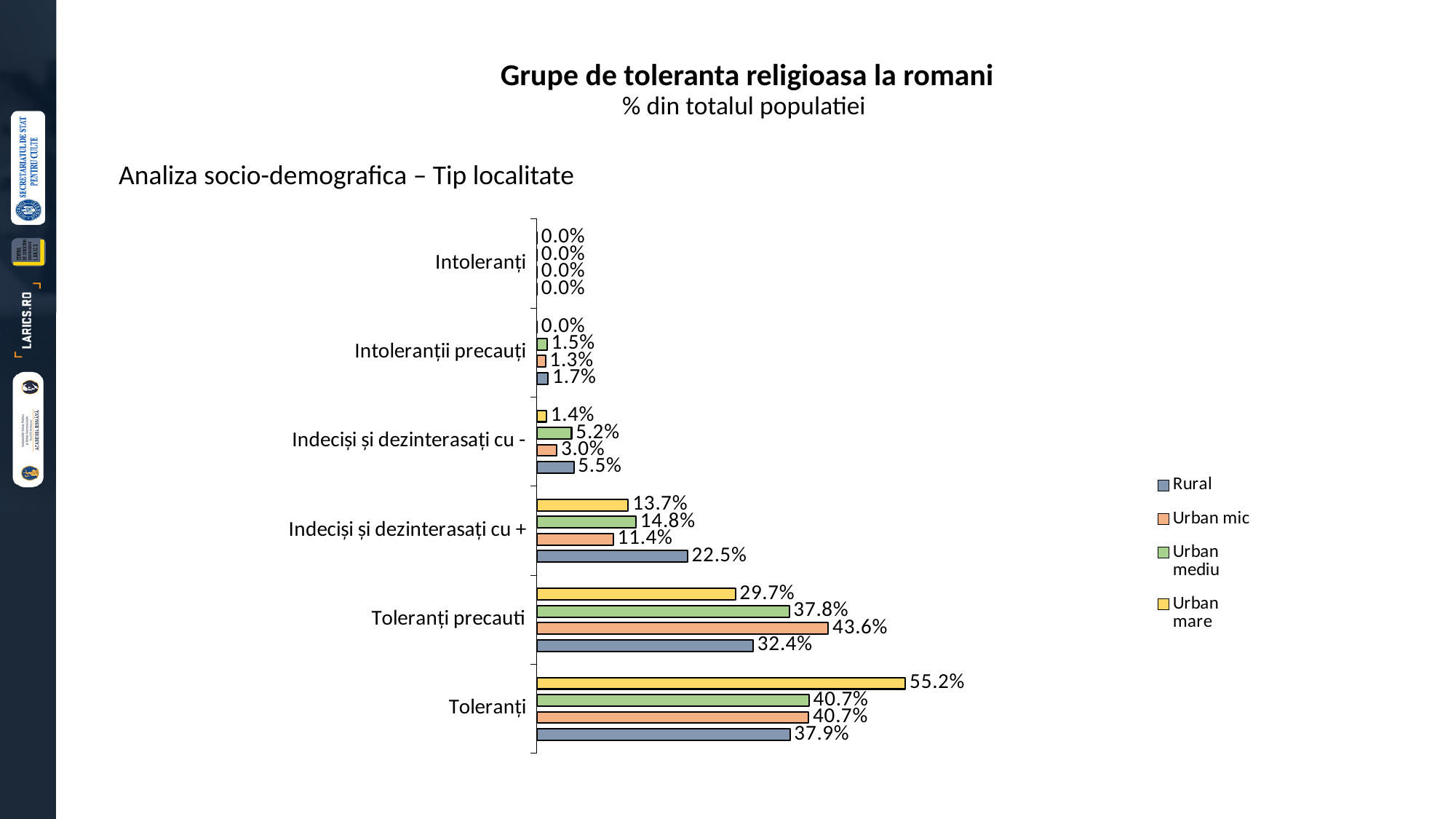
What is the value for Rural in the Indeciși și dezinterasați cu + category? 22.5% What is the value for Urban mic in the Toleranți precauti category? 43.6% How many series does the legend list? 4 Which series has the highest value in the Toleranți precauti category? Urban mic Which series has the lowest value in the Indeciși și dezinterasați cu + category? Urban mic What is the value for Urban mediu in the Intoleranții precauți category? 1.5% What is the title of the chart? Grupe de toleranta religioasa la romani What kind of chart is shown on the slide? bar chart What is the value for Urban mare in the Toleranți category? 55.2% How many categories are shown on the chart? 6 Which is larger in the Indeciși și dezinterasați cu - category: Rural or Urban mic? Rural What is the difference between the Urban mare and Rural values in the Toleranți category? 17.3%